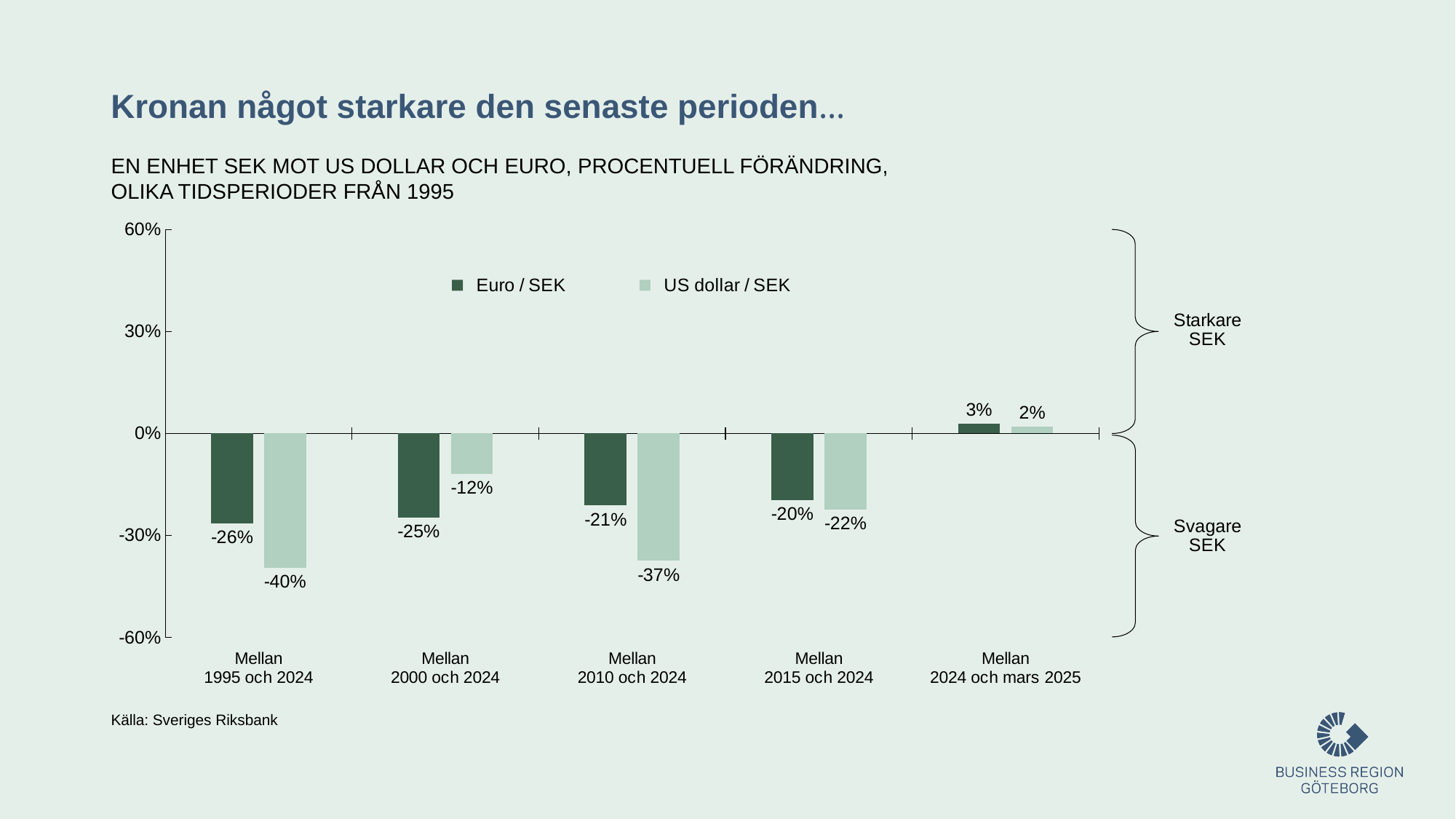
How many series does the legend list? 2 What is the US dollar / SEK value for 'Mellan 2010 och 2024'? -37% What is the Euro / SEK value for 'Mellan 1995 och 2024'? -26% How many time periods are shown on the x axis? 5 What is the US dollar / SEK value for 'Mellan 2000 och 2024'? -12% Which period has the highest Euro / SEK value? Mellan 2024 och mars 2025 What is the Euro / SEK value for 'Mellan 2024 och mars 2025'? 3% Which period has the lowest US dollar / SEK value? Mellan 1995 och 2024 What source is cited below the chart? Sveriges Riksbank What kind of chart is shown on the slide? Bar chart For 'Mellan 2015 och 2024', which is larger: the Euro / SEK value or the US dollar / SEK value? Euro / SEK What is the difference between the Euro / SEK and US dollar / SEK values for 'Mellan 2000 och 2024'? 13 percentage points